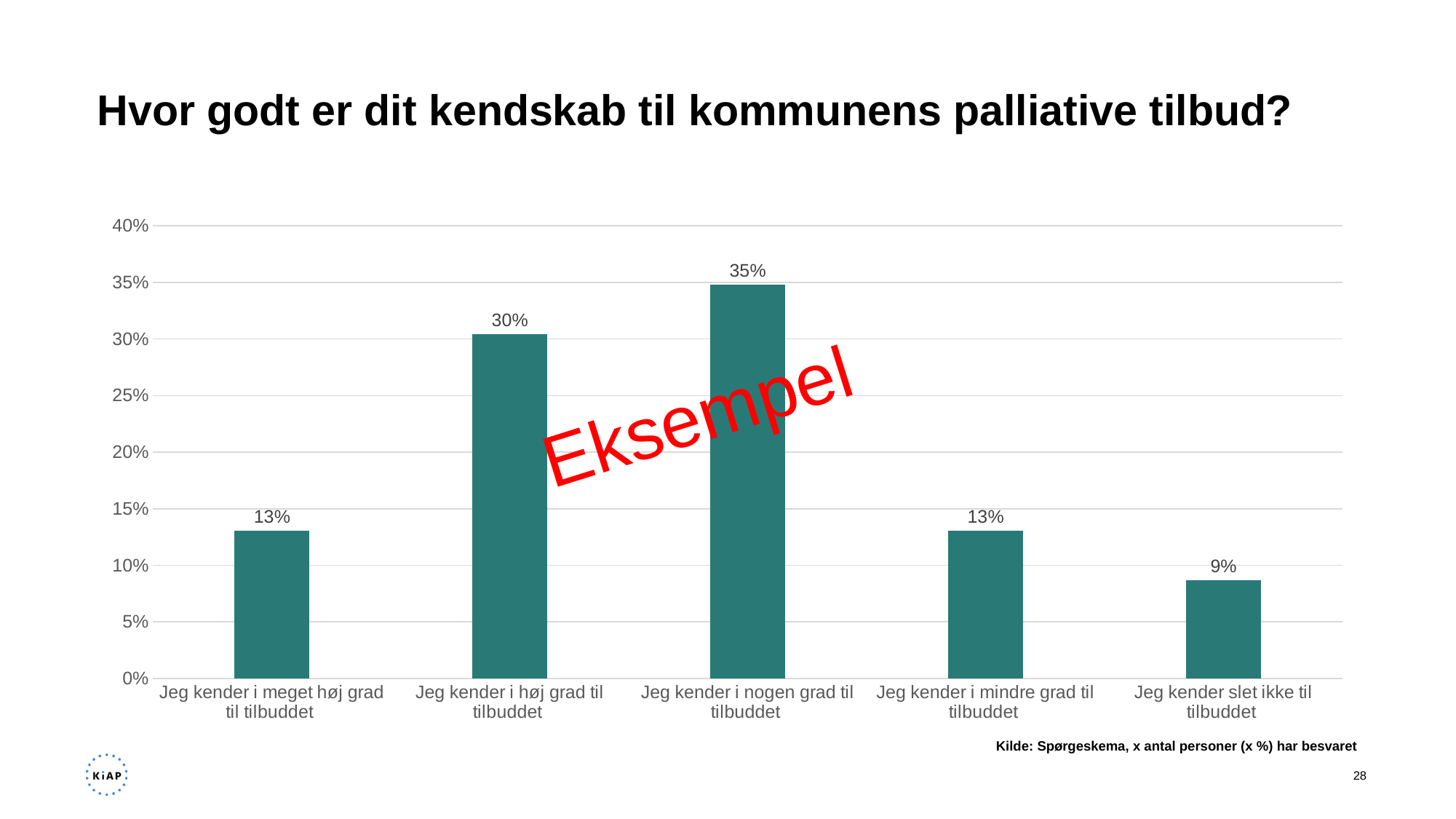
What kind of chart is shown on the slide? bar chart How many categories are shown on the x axis? 5 Which category has the lowest value? Jeg kender slet ikke til tilbuddet What is the value for "Jeg kender slet ikke til tilbuddet"? 9% Which is larger: the value for "Jeg kender i høj grad til tilbuddet" or "Jeg kender i mindre grad til tilbuddet"? Jeg kender i høj grad til tilbuddet What is the title of the slide? Hvor godt er dit kendskab til kommunens palliative tilbud? What is the difference between the values for "Jeg kender i nogen grad til tilbuddet" and "Jeg kender i høj grad til tilbuddet"? 5% Is the value for "Jeg kender slet ikke til tilbuddet" greater or less than 10%? less What is the value for "Jeg kender i høj grad til tilbuddet"? 30% What is the value for "Jeg kender i nogen grad til tilbuddet"? 35% Which category has the highest value? Jeg kender i nogen grad til tilbuddet What is the value for "Jeg kender i meget høj grad til tilbuddet"? 13%